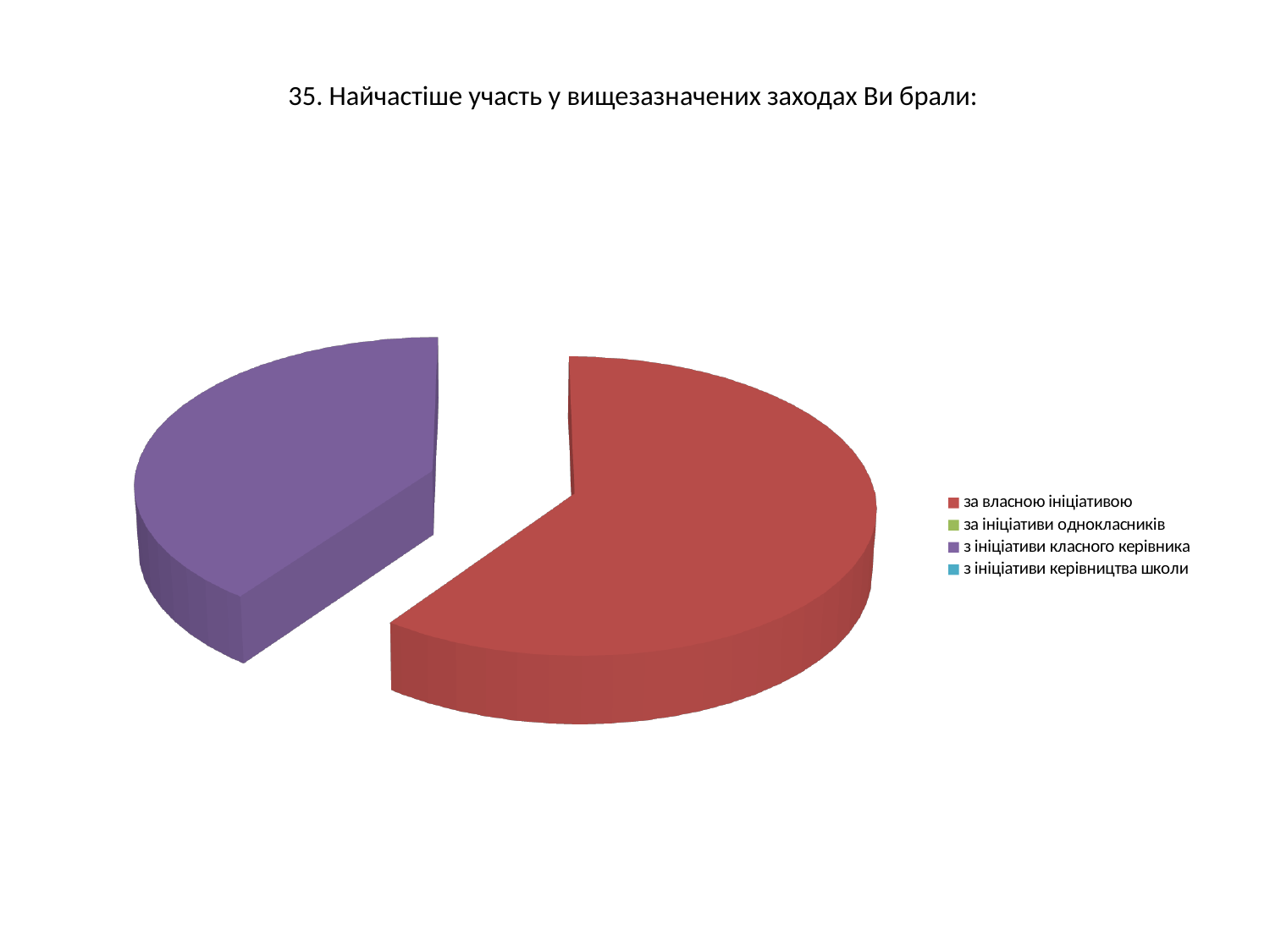
Is the share of "з ініціативи класного керівника" greater or less than half of the pie? less Is the share of "за власною ініціативою" greater or less than half of the pie? greater Which category has the largest slice of the pie? за власною ініціативою What colour is the slice for "з ініціативи класного керівника"? purple What is the title of the chart? 35. Найчастіше участь у вищезазначених заходах Ви брали: How many slices are visible in the pie? 2 How many entries does the legend list? 4 What kind of chart is shown on the slide? pie chart Which slice is larger: "за власною ініціативою" or "з ініціативи класного керівника"? за власною ініціативою